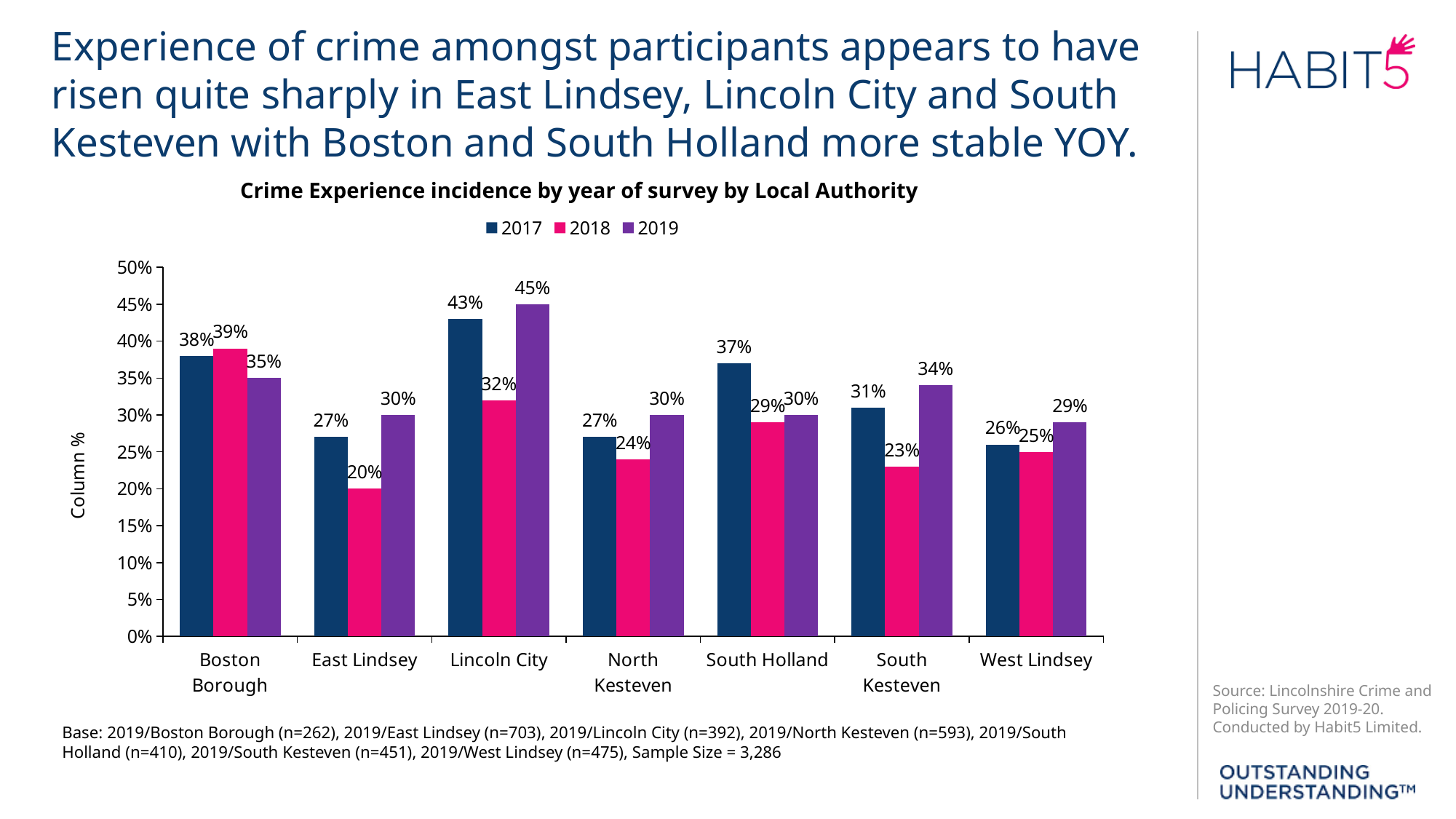
What is the difference between the 2019 and 2018 values for South Kesteven? 11% How many series does the legend list? 3 What is the 2018 value for East Lindsey? 20% Do the values for West Lindsey rise or fall from 2018 to 2019? Rise Which is larger for Boston Borough: the 2017 value or the 2019 value? 2017 What is the 2017 value for South Holland? 37% What kind of chart is shown? Bar chart Which local authority has the lowest 2018 value? East Lindsey How many local authorities are shown on the x axis? 7 What is the title of the chart? Crime Experience incidence by year of survey by Local Authority Which local authority has the highest 2019 value? Lincoln City What is the 2019 value for Lincoln City? 45%